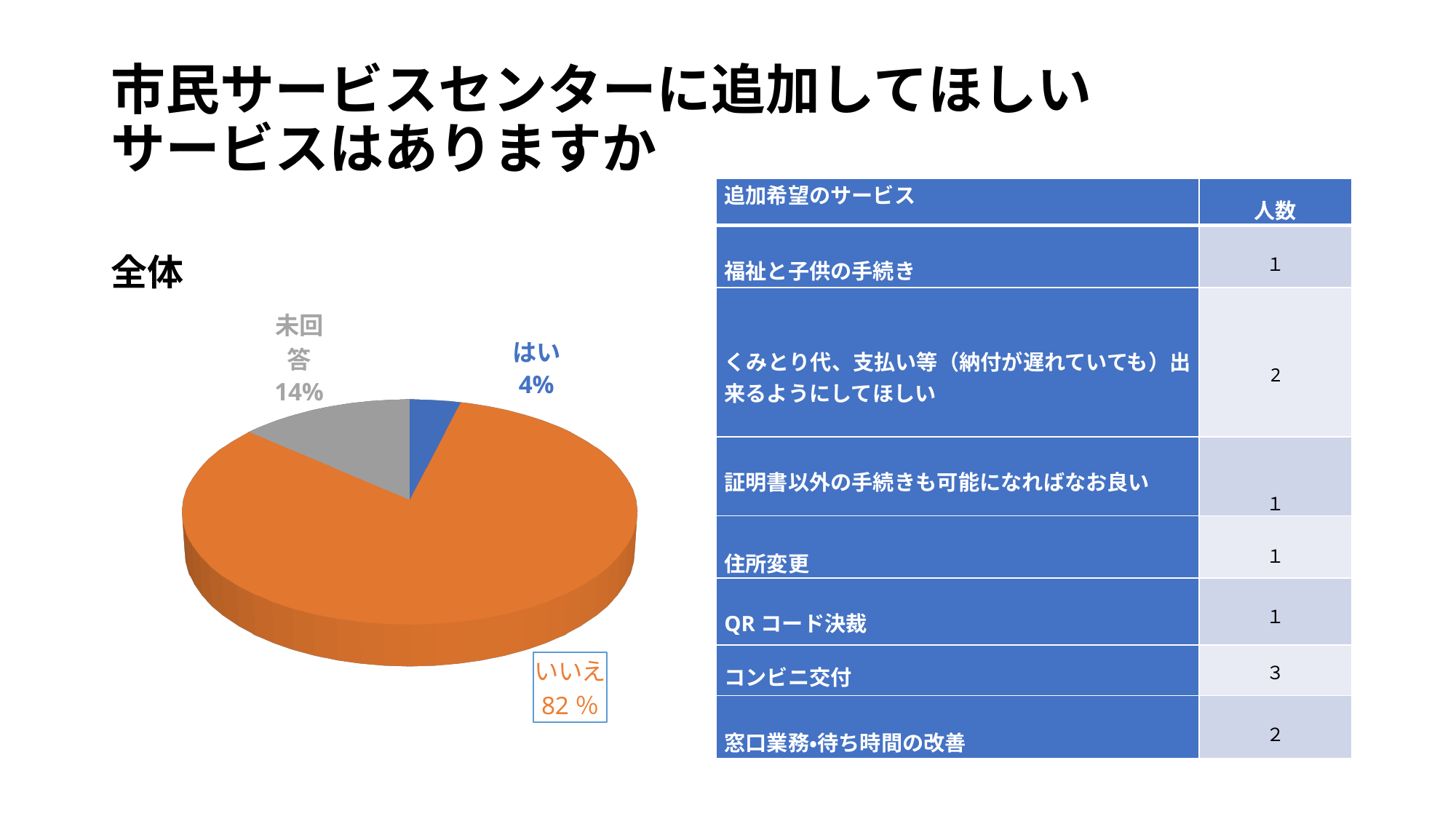
In the pie chart, what share is labelled for はい? 4% In the pie chart, what is the difference in percentage points between 未回答 and はい? 10 How many slices does the pie chart have? 3 What heading appears directly above the pie chart? 全体 Which slice of the pie chart is the smallest? はい In the pie chart, which is larger, the share for 未回答 or the share for はい? 未回答 In the pie chart, what share is labelled for いいえ? 82 % Which slice of the pie chart is the largest? いいえ In the pie chart, what share is labelled for 未回答? 14% What kind of chart is shown under the heading 全体? pie chart What colour is the いいえ slice in the pie chart? orange In the pie chart, what is the difference in percentage points between いいえ and 未回答? 68